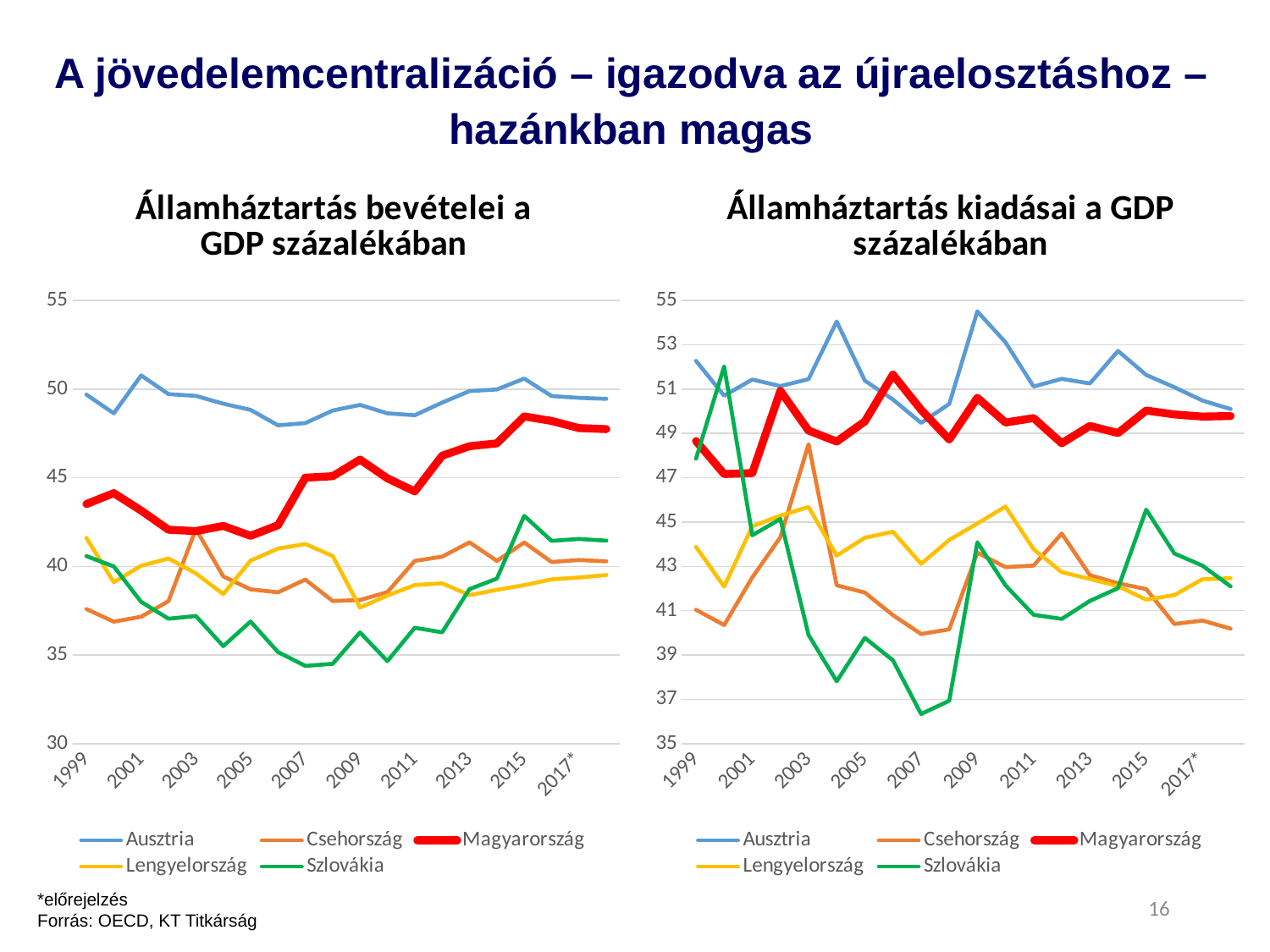
In the left chart (Államháztartás bevételei), does the Magyarország line rise or fall between 2007 and 2015? rise In the right chart (Államháztartás kiadásai), which is larger in 2017*: Magyarország or Csehország? Magyarország How many series does the legend of the right chart, 'Államháztartás kiadásai a GDP százalékában', list? 5 In the left chart, which colour is used for the Magyarország series? red In the right chart (Államháztartás kiadásai), which country has the lowest value in 2007? Szlovákia In the left chart (Államháztartás bevételei), which country has the highest value in 2017*? Ausztria In the right chart (Államháztartás kiadásai), is the value for Ausztria in 2009 greater or less than 53? greater In the right chart (Államháztartás kiadásai), which country has the highest value in 2009? Ausztria What kind of chart is the left chart, 'Államháztartás bevételei a GDP százalékában'? line chart In the left chart (Államháztartás bevételei), is the value for Magyarország in 1999 greater or less than 40? greater In the right chart (Államháztartás kiadásai), is the value for Szlovákia in 2007 greater or less than 37? less In the left chart (Államháztartás bevételei), which country has the lowest value in 2008? Szlovákia